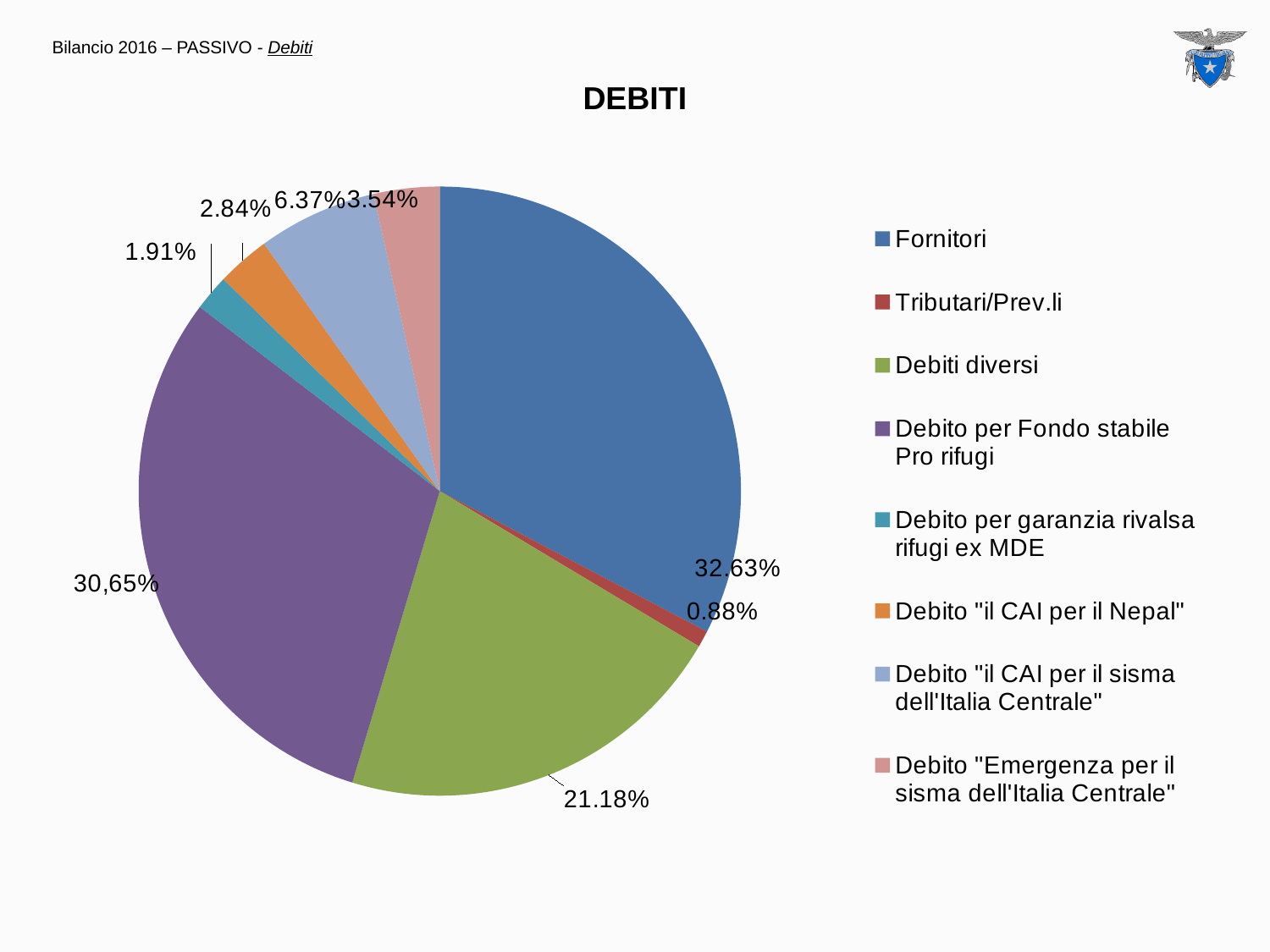
What is the title of the chart? DEBITI What is the difference between the share for Fornitori and the share for Debiti diversi? 11.45% Which category has the smallest slice of the pie? Tributari/Prev.li What share of the pie does Fornitori represent? 32.63% What kind of chart is shown on the slide? Pie chart What share of the pie does Debito per Fondo stabile Pro rifugi represent? 30,65% How many entries does the legend list? 8 Which is larger, the slice for Debito "il CAI per il Nepal" or the slice for Debito "Emergenza per il sisma dell'Italia Centrale"? Debito "Emergenza per il sisma dell'Italia Centrale" What is the value shown for Debito "il CAI per il sisma dell'Italia Centrale"? 6.37% What is the value shown for Tributari/Prev.li? 0.88% Which category has the largest slice of the pie? Fornitori What share of the pie does Debiti diversi represent? 21.18%